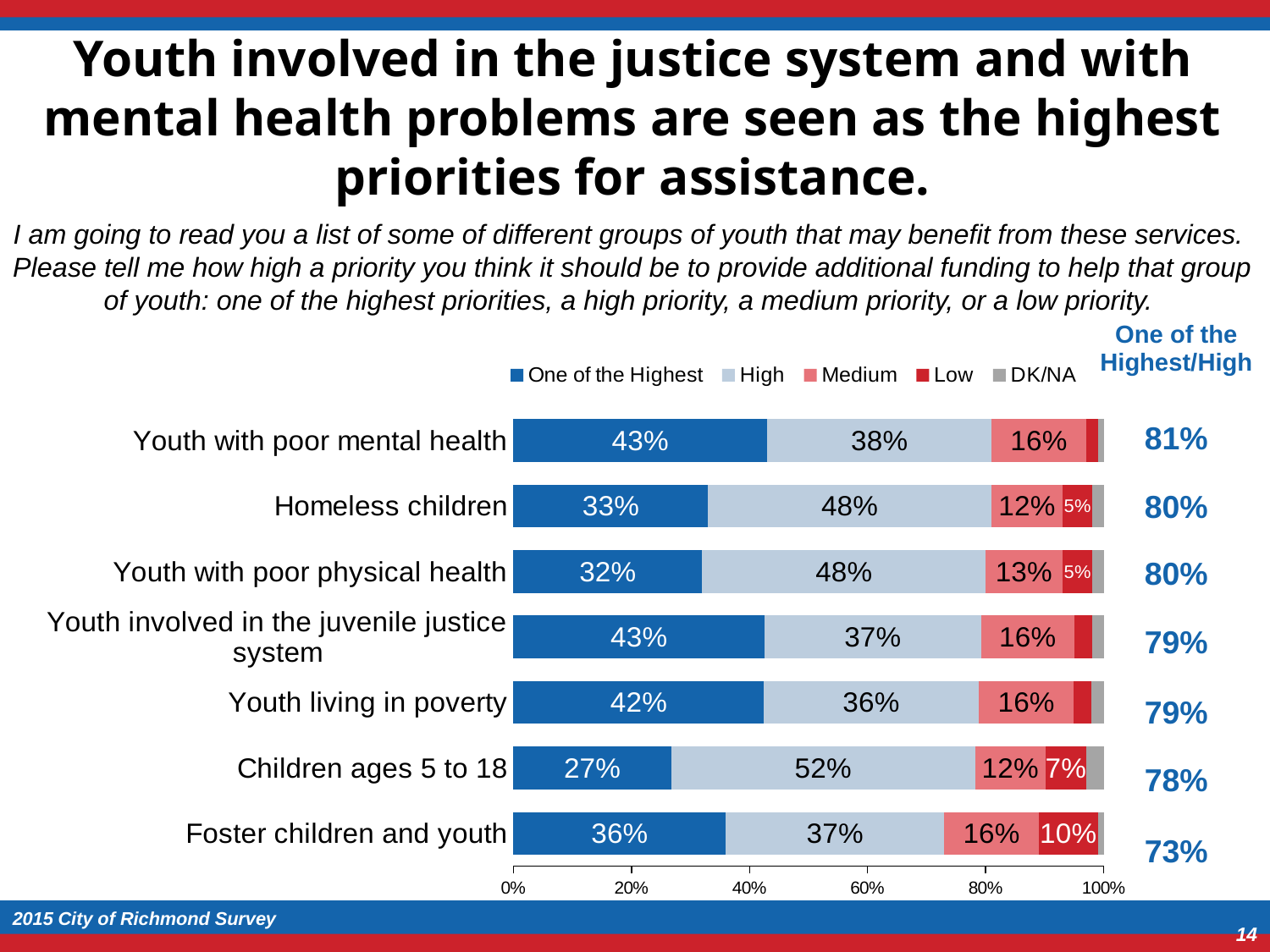
Which group has the lowest "One of the Highest" percentage? Children ages 5 to 18 How many groups of youth are shown in the chart? 7 What is the "Low" value for Children ages 5 to 18? 7% What percentage of respondents rated Youth with poor mental health as "One of the Highest" priority? 43% What is the "Medium" value for Foster children and youth? 16% What is the combined "One of the Highest/High" figure shown for Youth involved in the juvenile justice system? 79% Which group has the highest combined "One of the Highest/High" figure? Youth with poor mental health Which group has the lowest combined "One of the Highest/High" figure? Foster children and youth Which has a larger "High" value: Homeless children or Youth living in poverty? Homeless children What is the difference in the "One of the Highest" percentage between Youth with poor mental health and Children ages 5 to 18? 16 percentage points What is the "High" value for Children ages 5 to 18? 52% How many series does the legend list? 5